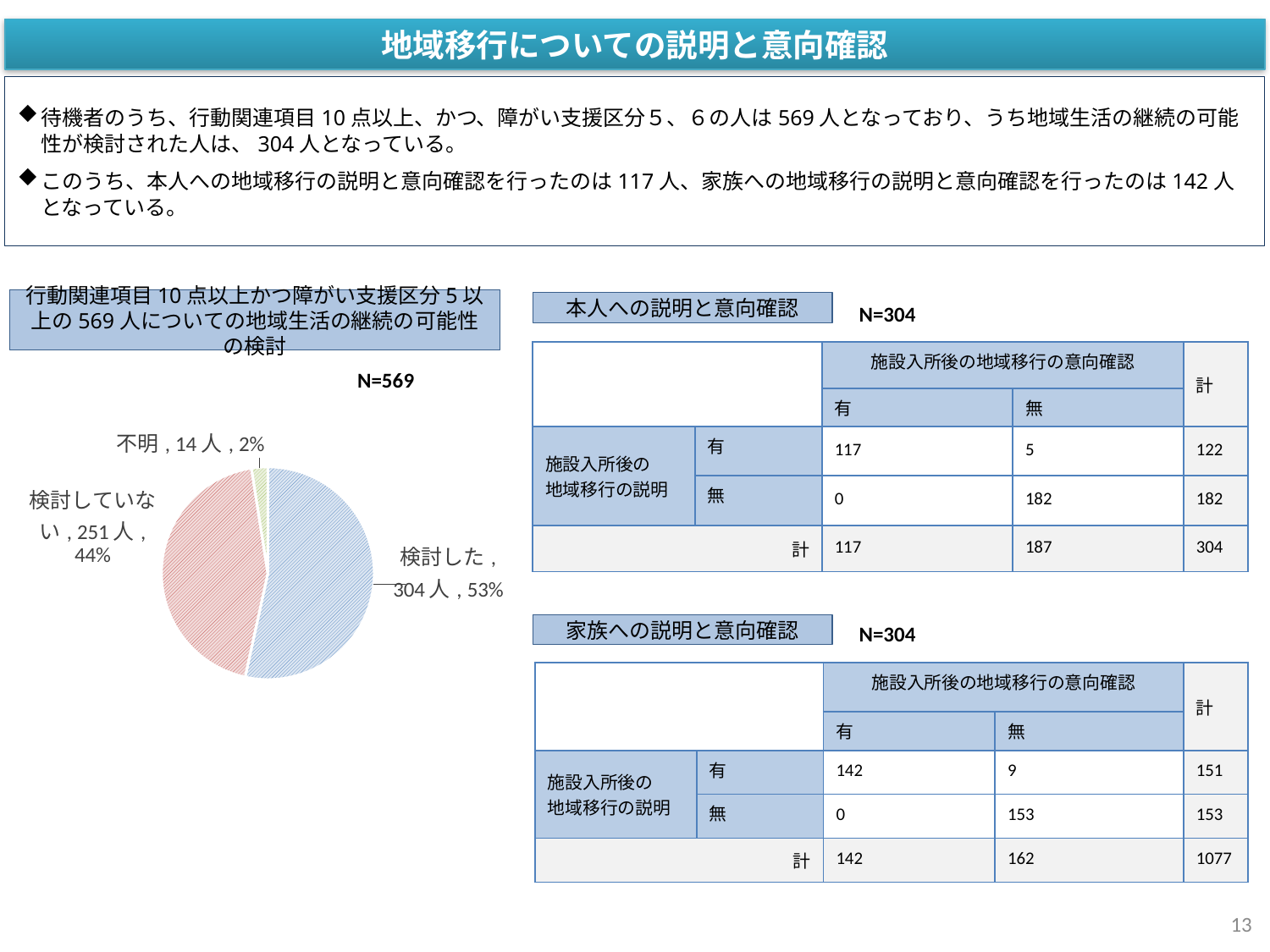
In the pie chart, how many people are in the 不明 category? 14人 What is the difference in people between the 検討した and 検討していない slices of the pie chart? 53人 Which category in the pie chart has the largest number of people? 検討した In the pie chart, how many people are in the 検討した category? 304人 What kind of chart is shown on the left of the slide? pie chart What share of the pie does the 不明 slice represent? 2% What is the N value shown above the pie chart? N=569 In the pie chart, how many people are in the 検討していない category? 251人 How many slices does the pie chart have? 3 Which category in the pie chart has the smallest number of people? 不明 What share of the pie does the 検討した slice represent? 53% What share of the pie does the 検討していない slice represent? 44%